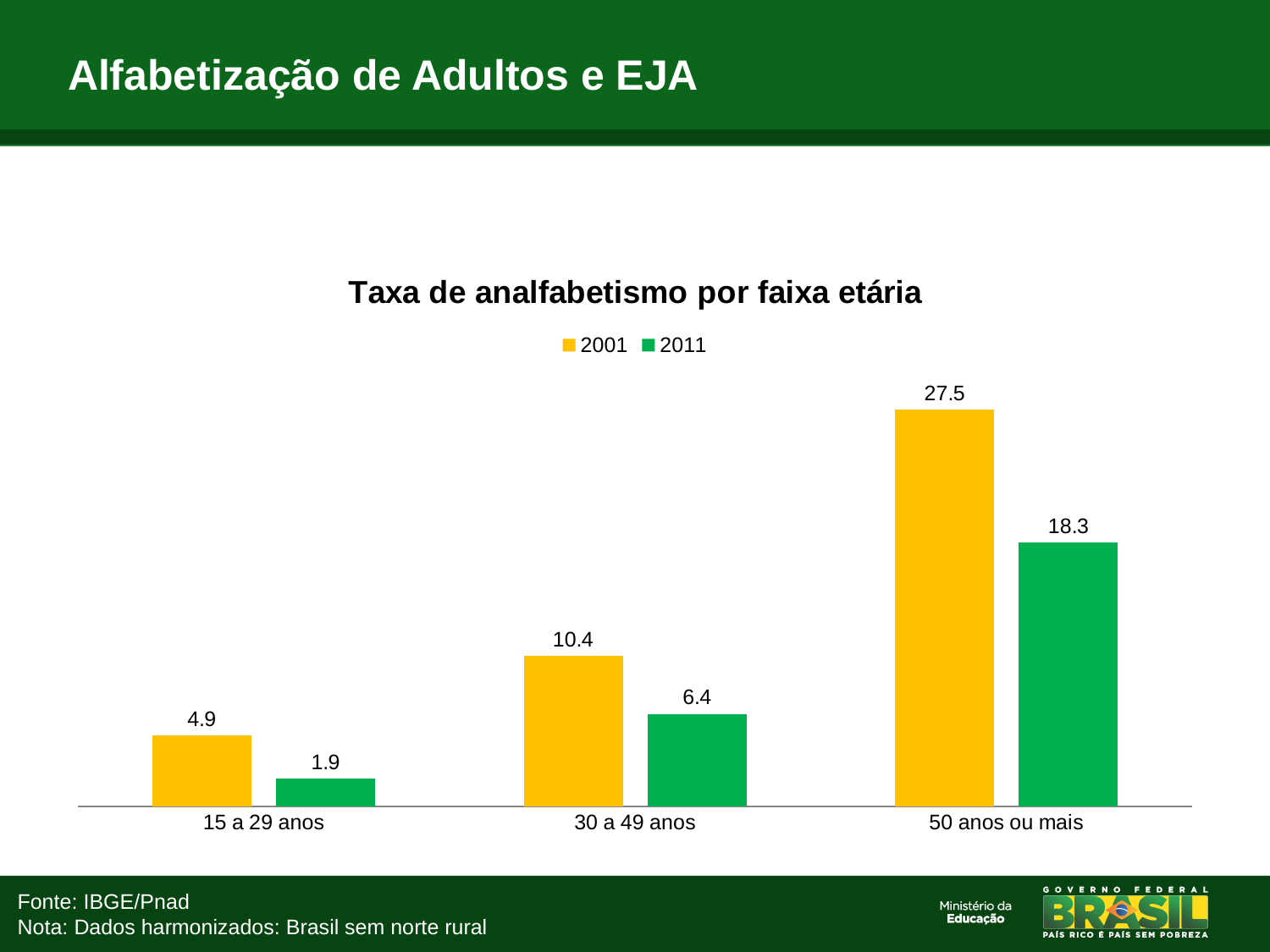
How many series does the legend list? 2 How many age groups are shown on the x axis? 3 Which age group has the lowest 2011 value? 15 a 29 anos Which age group has the highest 2001 value? 50 anos ou mais Which is larger for the 15 a 29 anos age group, the 2001 value or the 2011 value? 2001 What is the 2001 value for the 50 anos ou mais age group? 27.5 What is the difference between the 2001 and 2011 values for the 30 a 49 anos age group? 4 What is the difference between the 2001 and 2011 values for the 50 anos ou mais age group? 9.2 What is the 2011 value for the 30 a 49 anos age group? 6.4 What kind of chart is shown on the slide? Bar chart What is the title of the chart? Taxa de analfabetismo por faixa etária What is the 2011 value for the 15 a 29 anos age group? 1.9